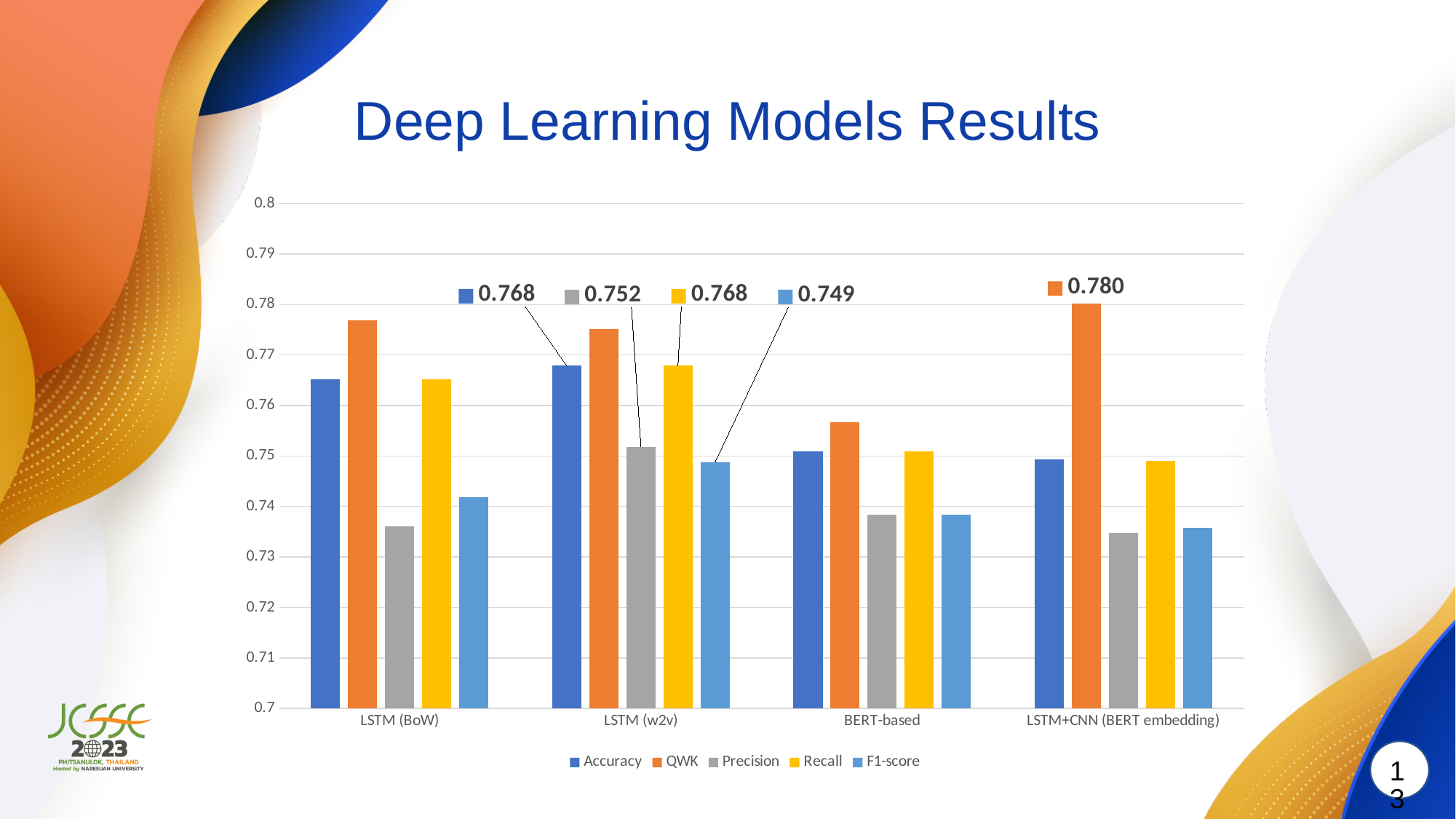
For LSTM (BoW), which is larger: the QWK value or the Accuracy value? QWK Which model has the highest QWK value? LSTM+CNN (BERT embedding) What type of chart is shown on the slide? Bar chart What is the F1-score value for LSTM (w2v)? 0.749 What is the difference between the Accuracy and Precision values for LSTM (w2v)? 0.016 Is the QWK value for BERT-based greater or less than 0.75? greater What is the QWK value for LSTM+CNN (BERT embedding)? 0.780 What is the Accuracy value for LSTM (w2v)? 0.768 How many series does the legend list? 5 What is the Precision value for LSTM (w2v)? 0.752 Is the Precision value for LSTM (BoW) greater or less than 0.74? less How many models are shown on the x axis? 4